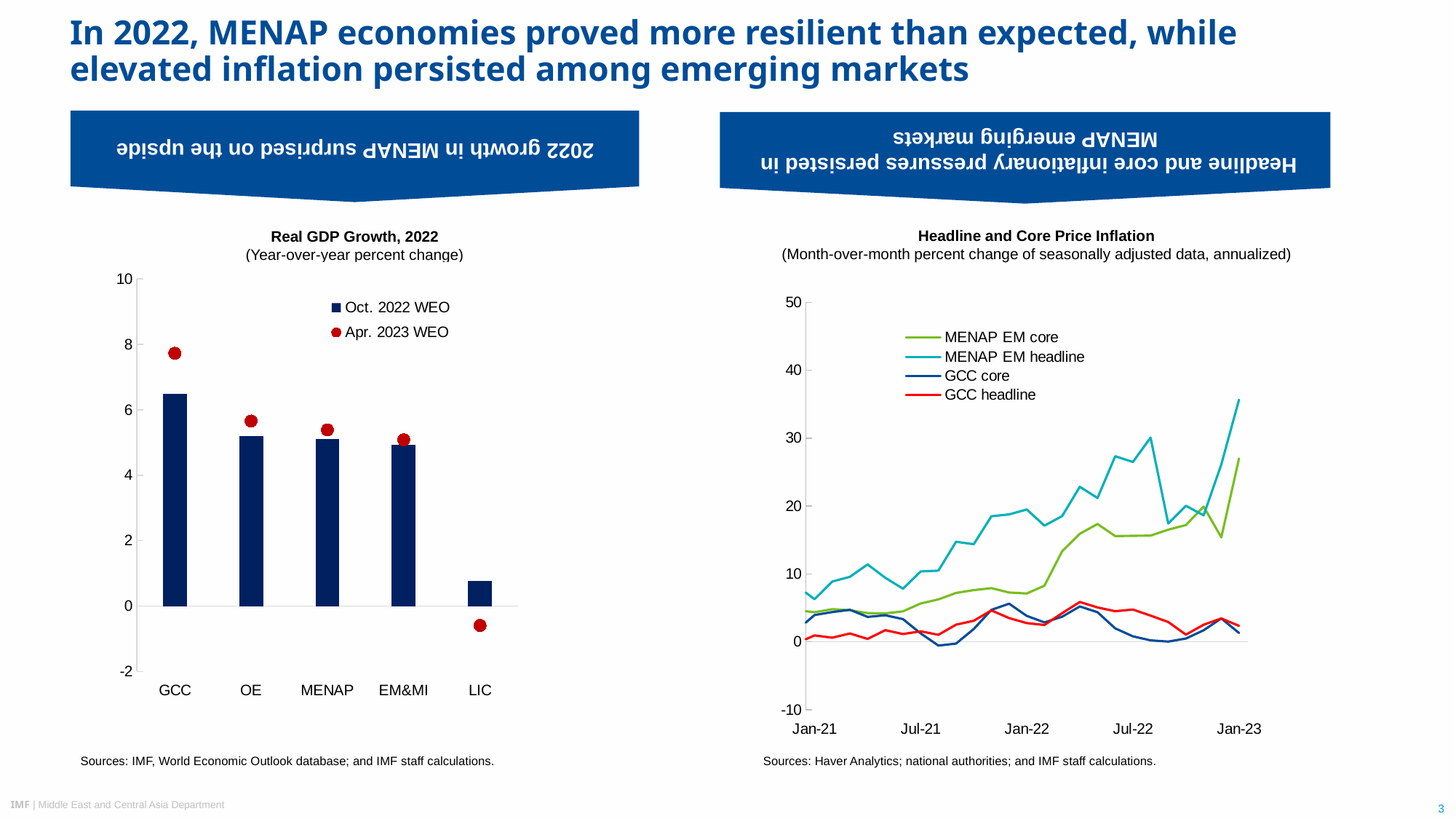
In the Real GDP Growth, 2022 chart, is the Apr. 2023 WEO value for LIC greater or less than 0? less What kind of chart is the Headline and Core Price Inflation chart? Line chart In the Real GDP Growth, 2022 chart, which category has the highest Oct. 2022 WEO bar? GCC In the Real GDP Growth, 2022 chart, what kind of chart is used for the Oct. 2022 WEO series? Bar chart In the Real GDP Growth, 2022 chart, how many categories are shown on the x axis? 5 In the Headline and Core Price Inflation chart, how many series does the legend list? 4 In the Headline and Core Price Inflation chart, does the MENAP EM core series rise or fall from Jan-21 to Jan-23? Rise In the Real GDP Growth, 2022 chart, which is larger, the Oct. 2022 WEO bar for GCC or for LIC? GCC In the Headline and Core Price Inflation chart, is the MENAP EM headline value at Jan-23 greater or less than 30? greater In the Real GDP Growth, 2022 chart, is the Oct. 2022 WEO value for GCC greater or less than 6? greater In the Real GDP Growth, 2022 chart, how many series does the legend list? 2 In the Real GDP Growth, 2022 chart, which category has the lowest Oct. 2022 WEO bar? LIC